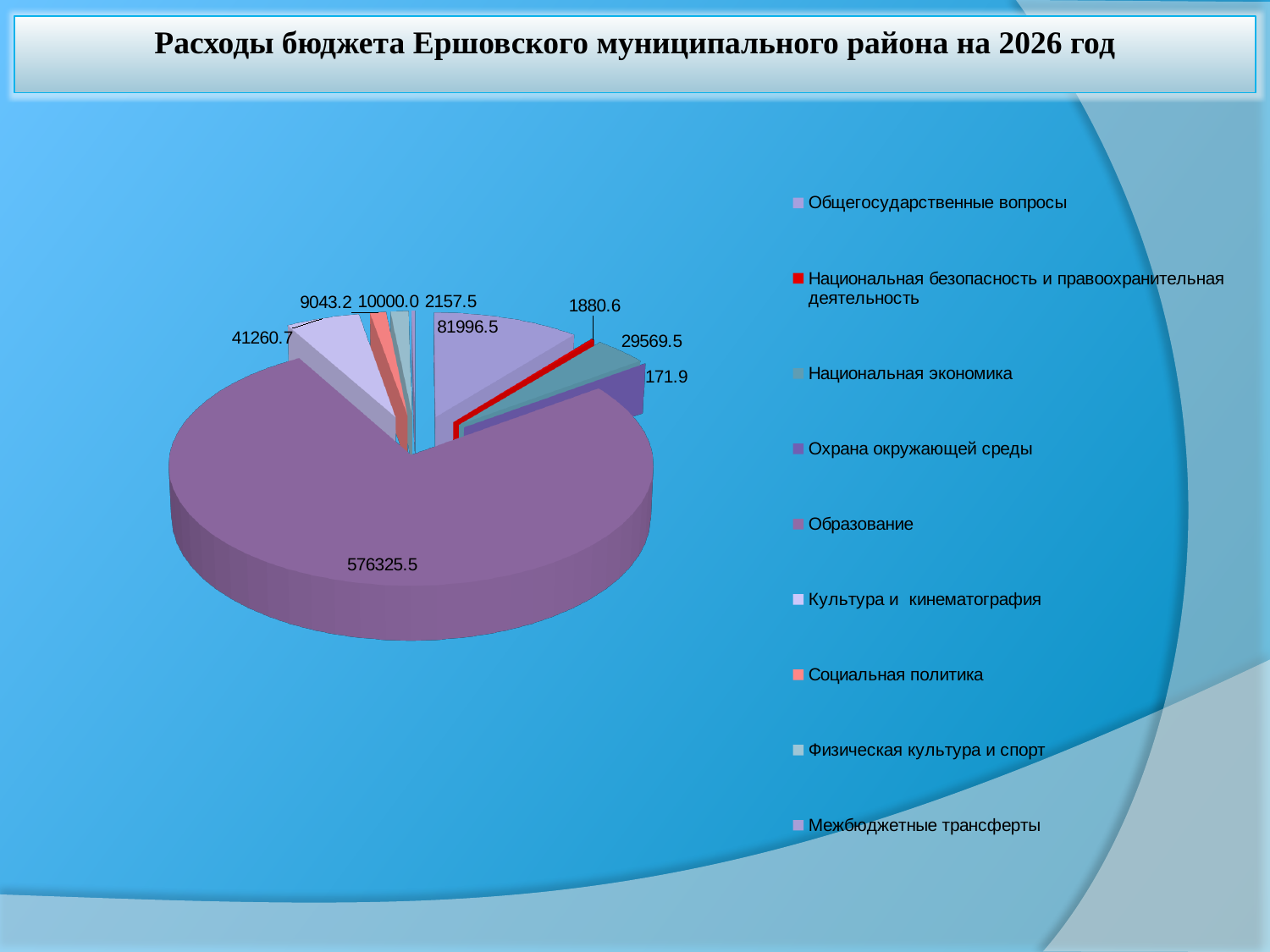
What is the value for Образование? 576325.5 Which category has the smallest slice of the pie? Охрана окружающей среды What type of chart is shown on the slide? pie chart What is the value for Национальная безопасность и правоохранительная деятельность? 1880.6 What is the value for Культура и кинематография? 41260.7 How many categories does the legend list? 9 What is the value for Общегосударственные вопросы? 81996.5 What is the value for Национальная экономика? 29569.5 What is the difference between the values for Общегосударственные вопросы and Культура и кинематография? 40735.8 Which is larger, the value for Национальная экономика or the value for Культура и кинематография? Культура и кинематография What is the title of the slide? Расходы бюджета Ершовского муниципального района на 2026 год Which category has the largest slice of the pie? Образование